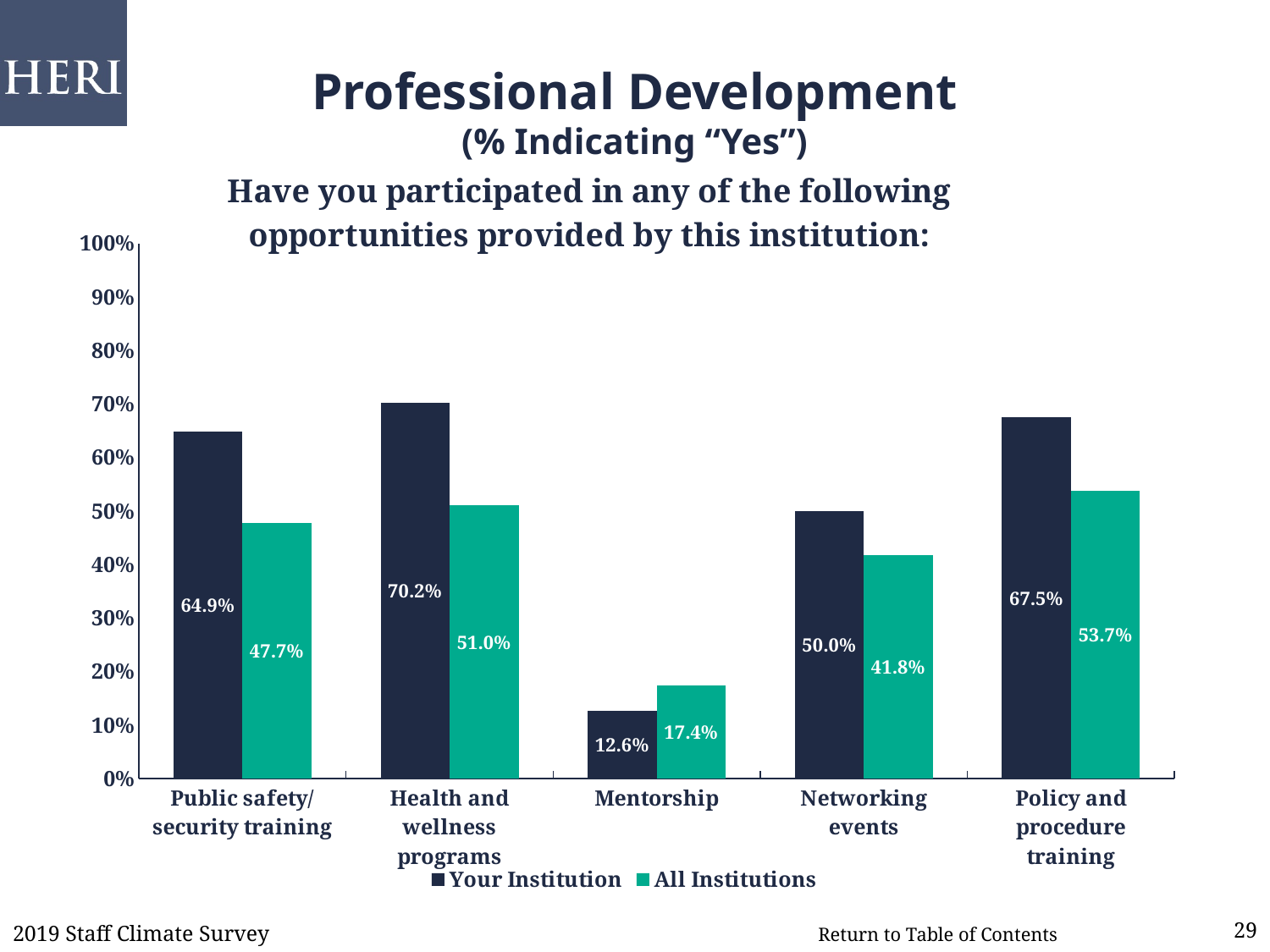
What is the value for All Institutions for Policy and procedure training? 53.7% What is the difference between Your Institution and All Institutions for Public safety/security training? 17.2% What is the value for Your Institution for Mentorship? 12.6% What is the value for Your Institution for Networking events? 50.0% Which is larger for Mentorship: Your Institution or All Institutions? All Institutions Is the value for All Institutions for Networking events greater or less than 50%? less What kind of chart is shown on the slide? Bar chart Which category has the highest value for Your Institution? Health and wellness programs Which category has the lowest value for All Institutions? Mentorship How many categories are shown on the x axis? 5 How many series does the legend list? 2 What is the difference between Your Institution and All Institutions for Health and wellness programs? 19.2%